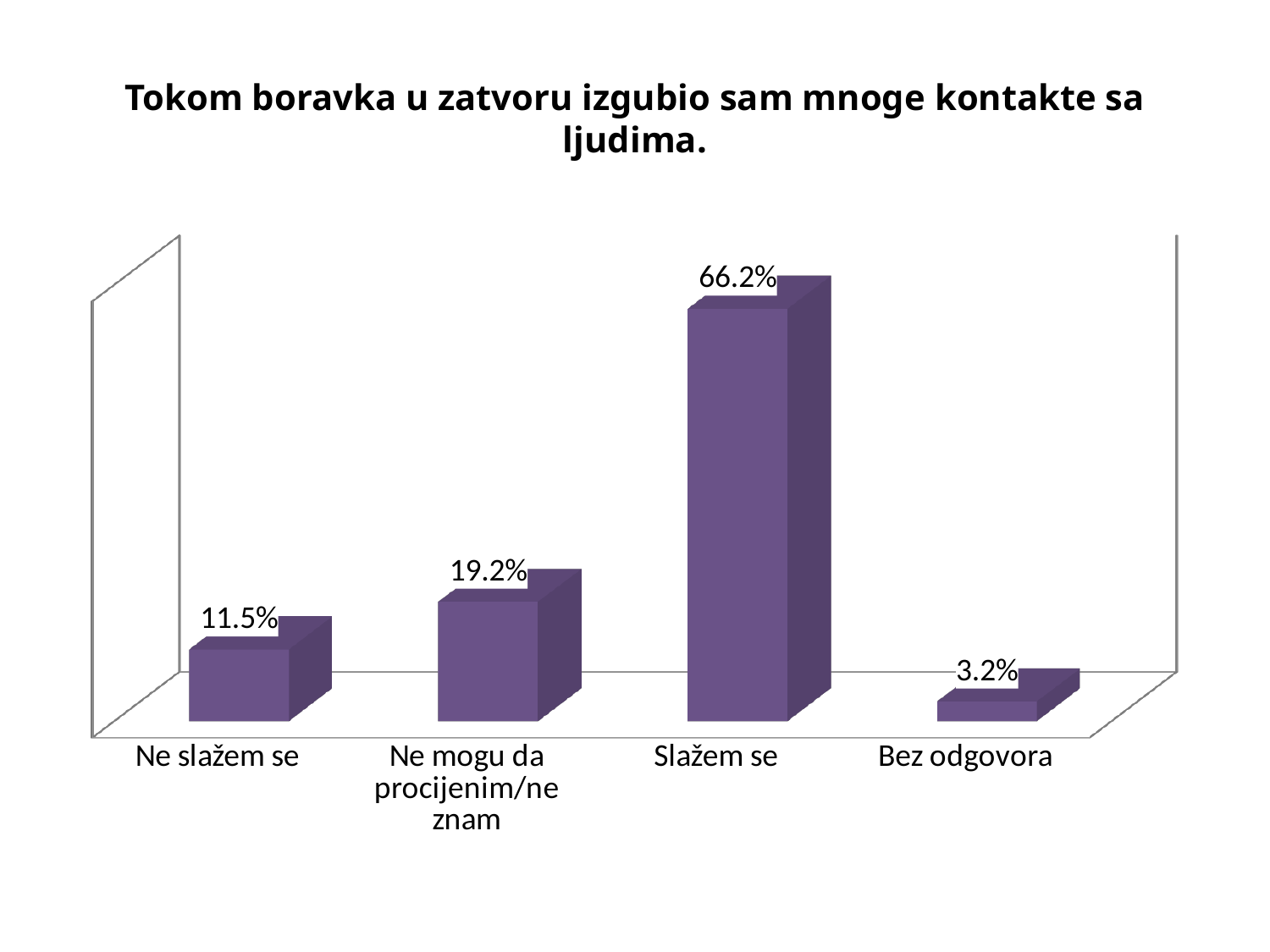
What is the value for "Ne mogu da procijenim/ne znam"? 19.2% What is the difference between the values for "Ne mogu da procijenim/ne znam" and "Bez odgovora"? 16.0% Which category has the lowest value? Bez odgovora What is the value for "Ne slažem se"? 11.5% What kind of chart is shown on the slide? Bar chart What is the value for "Bez odgovora"? 3.2% How many categories are shown on the chart? 4 What is the difference between the values for "Slažem se" and "Ne slažem se"? 54.7% What is the value for "Slažem se"? 66.2% Which is larger, the value for "Ne mogu da procijenim/ne znam" or the value for "Ne slažem se"? Ne mogu da procijenim/ne znam Which category has the highest value? Slažem se What is the title of the chart? Tokom boravka u zatvoru izgubio sam mnoge kontakte sa ljudima.